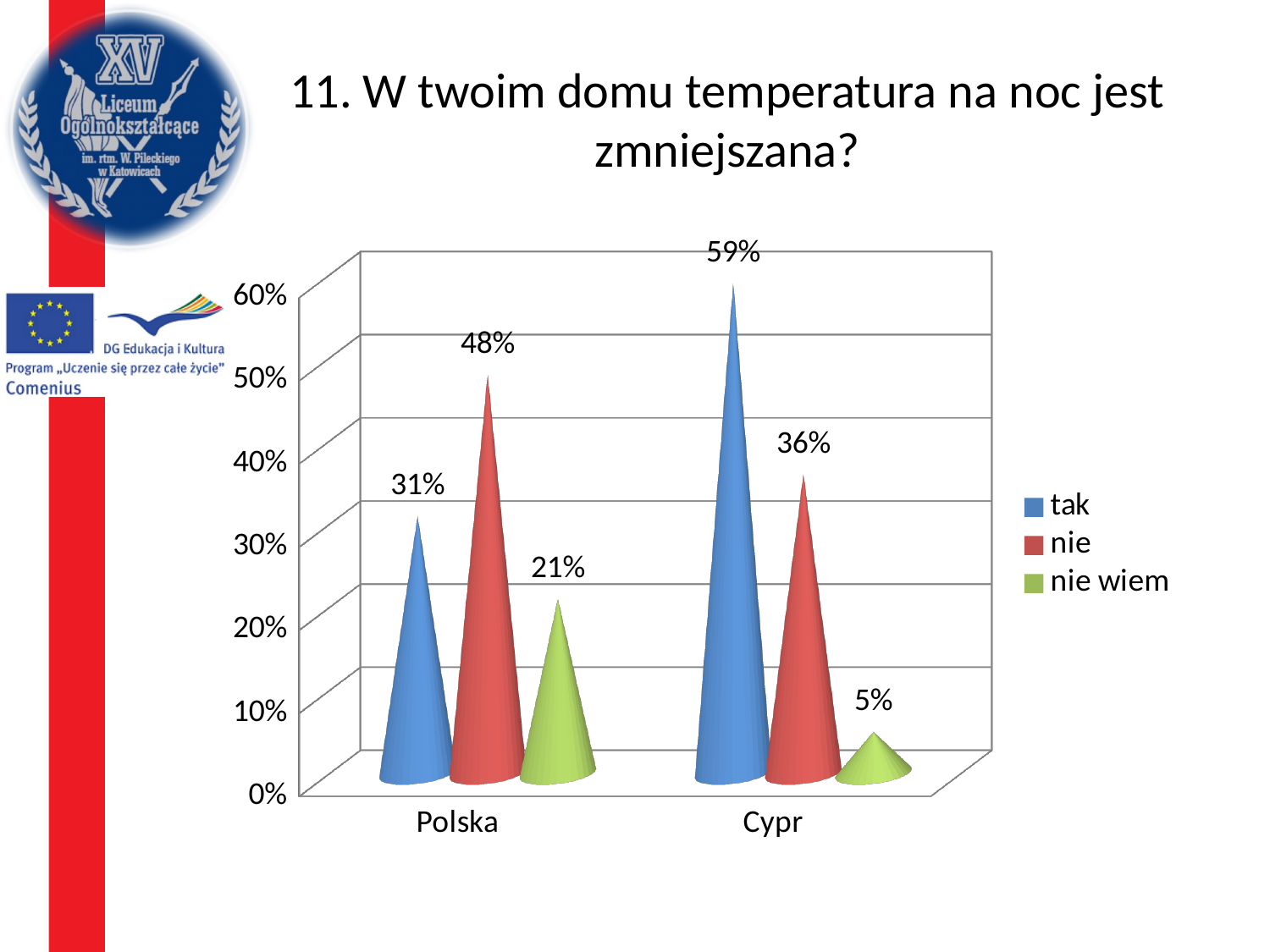
What is the value for "nie" in Cypr? 36% What kind of chart is shown on the slide? bar chart How many categories are shown on the x axis? 2 What is the value for "tak" in Polska? 31% Which series has the highest value in Cypr? tak What is the value for "nie wiem" in Polska? 21% Which series has the highest value in Polska? nie What is the difference between the "tak" values for Cypr and Polska? 28% Which is larger: "nie" in Polska or "nie" in Cypr? nie in Polska How many series does the legend list? 3 Which series has the lowest value in Cypr? nie wiem What is the value for "nie wiem" in Cypr? 5%